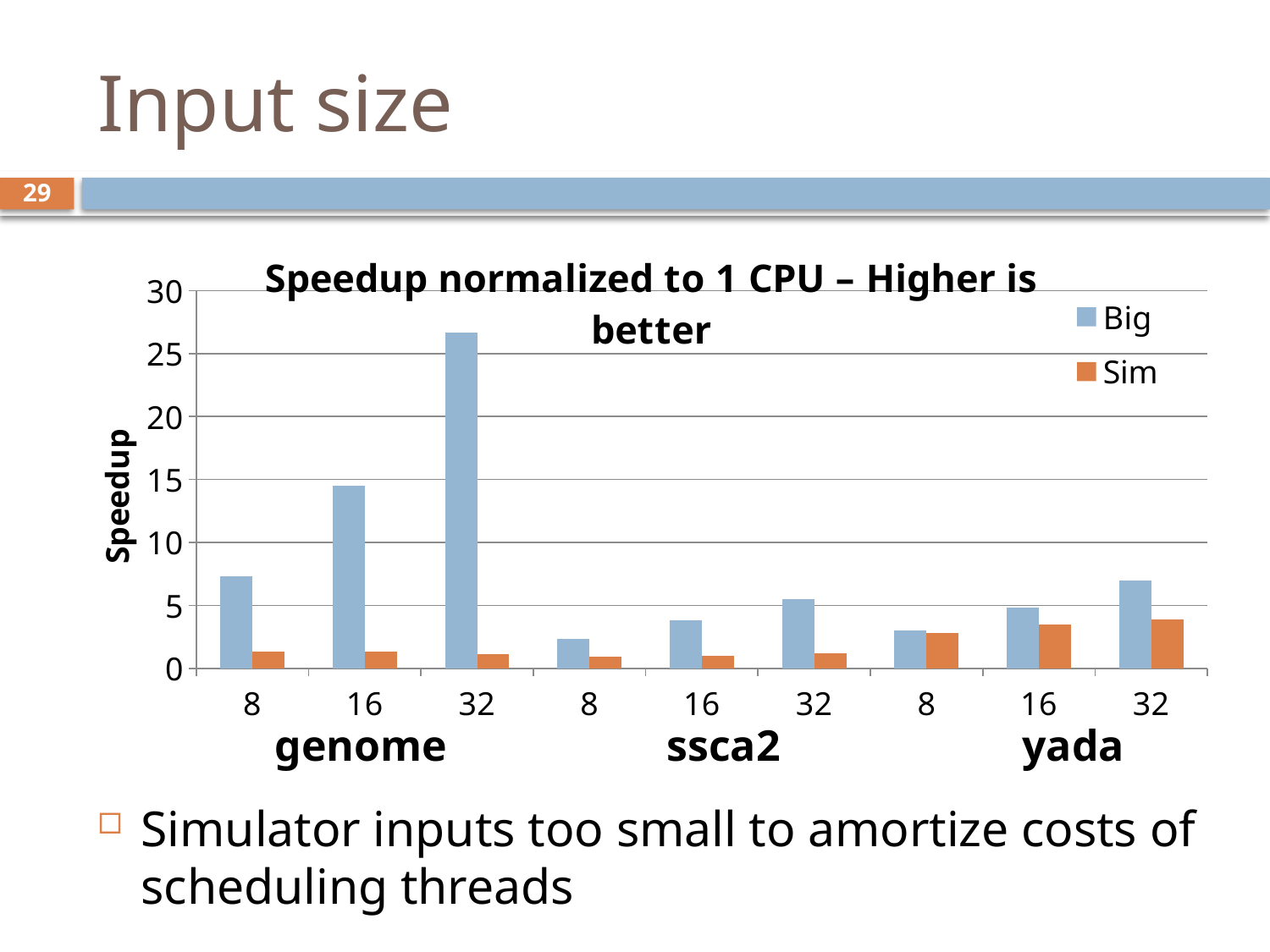
Do the Big speedup bars for ssca2 rise or fall as the thread count increases from 8 to 32? rise Is the Big speedup for genome at 32 threads greater or less than 25? greater For genome at 32 threads, which series has the larger speedup, Big or Sim? Big Is the Sim speedup for yada at 32 threads greater or less than 5? less Is the Big speedup for genome at 16 threads greater or less than 10? greater How many benchmarks are shown along the x axis? 3 How many series does the legend list? 2 What are the two series named in the legend? Big and Sim What kind of chart is shown on the slide? bar chart What is the title of the y axis? Speedup For which benchmark and thread count is the Big speedup lowest? ssca2 at 8 For which benchmark and thread count is the Big speedup highest? genome at 32